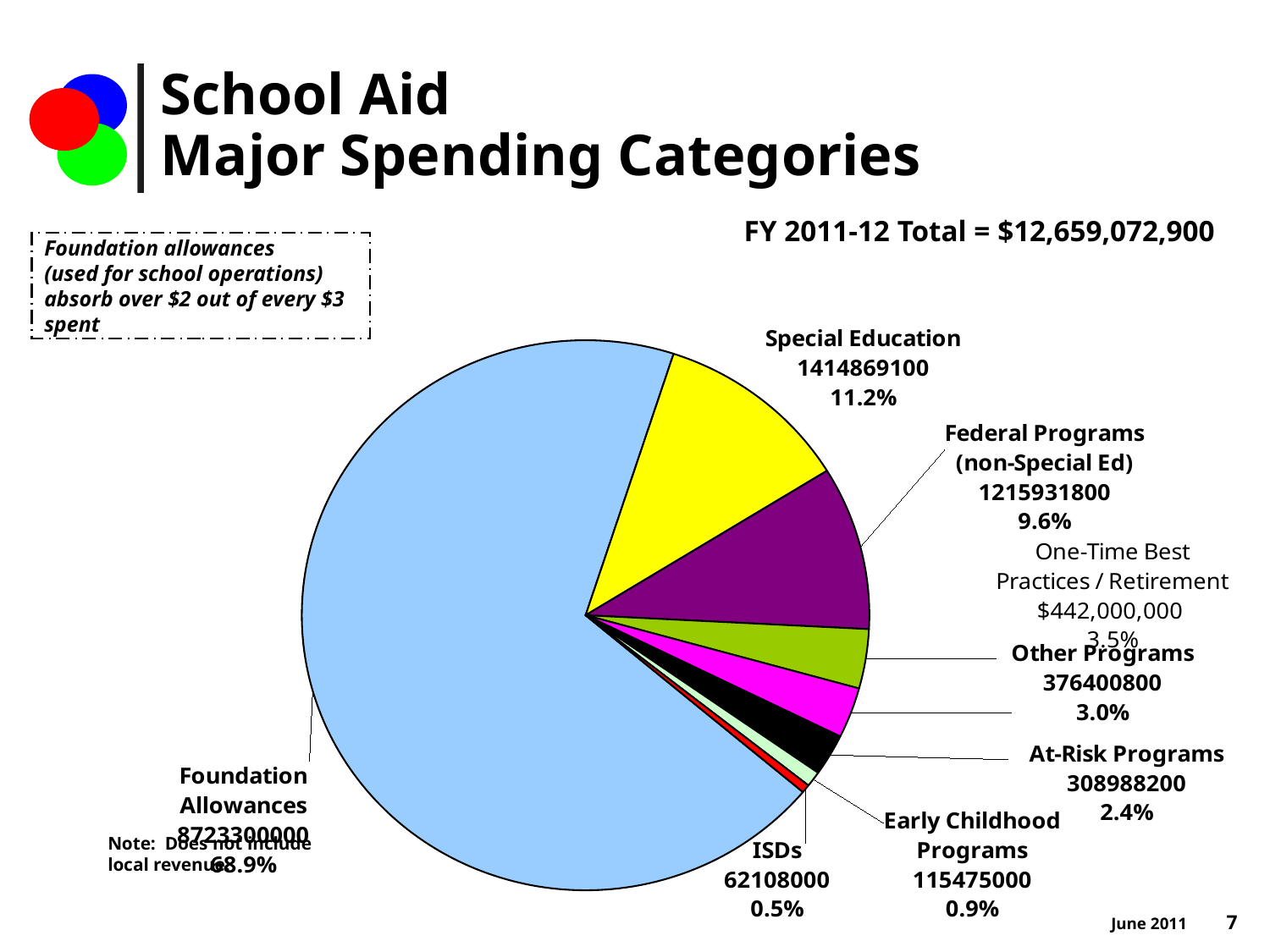
What type of chart is shown on the slide? Pie chart What percentage share is shown for Early Childhood Programs? 0.9% What is the amount shown for One-Time Best Practices / Retirement? $442,000,000 What is the dollar amount shown for Special Education? 1414869100 How many spending categories are shown in the pie chart? 8 What is the FY 2011-12 total shown above the chart? $12,659,072,900 What percentage of School Aid spending goes to Foundation Allowances? 68.9% Which spending category has the smallest share of the pie? ISDs What percentage share is shown for Federal Programs (non-Special Ed)? 9.6% Which spending category has the largest share of the pie? Foundation Allowances Which is larger, the share for Other Programs or the share for At-Risk Programs? Other Programs What is the difference in percentage points between Special Education (11.2%) and Federal Programs (non-Special Ed) (9.6%)? 1.6 percentage points